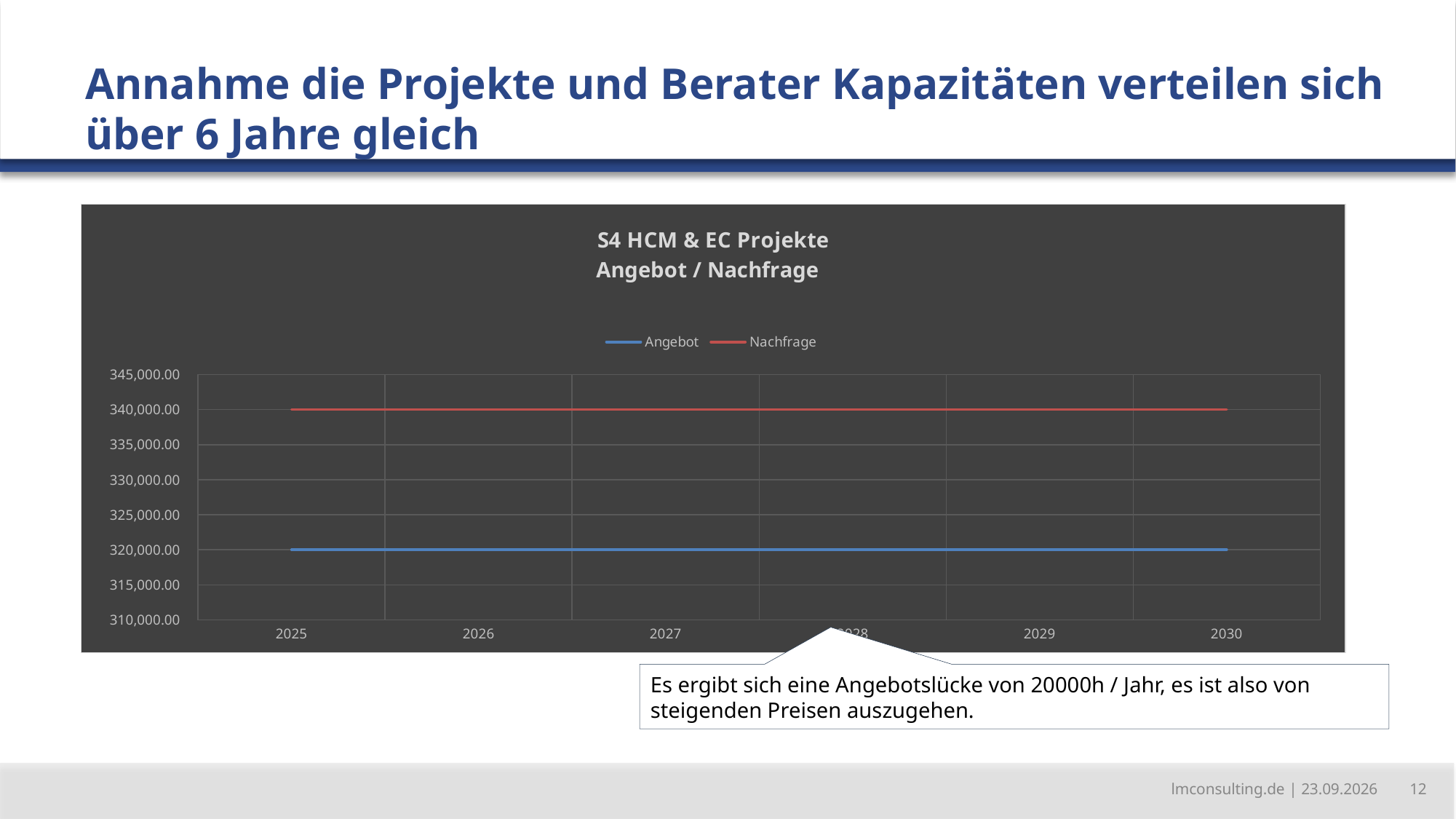
Which series has the higher values, Angebot or Nachfrage? Nachfrage What is the value of Nachfrage in 2030? 340,000.00 How many series does the chart legend list? 2 What is the difference between Nachfrage and Angebot in 2028? 20,000.00 Is the value for Angebot in 2026 greater or less than 330,000.00? less What is the title of the chart? S4 HCM & EC Projekte Angebot / Nachfrage What kind of chart is shown on the slide? line chart How many years are shown on the x axis of the chart? 6 Do the Angebot values rise, fall or stay flat from 2025 to 2030? stay flat What is the value of Nachfrage in 2027? 340,000.00 What is the value of Angebot in 2025? 320,000.00 Which colour is used for the Nachfrage line? red